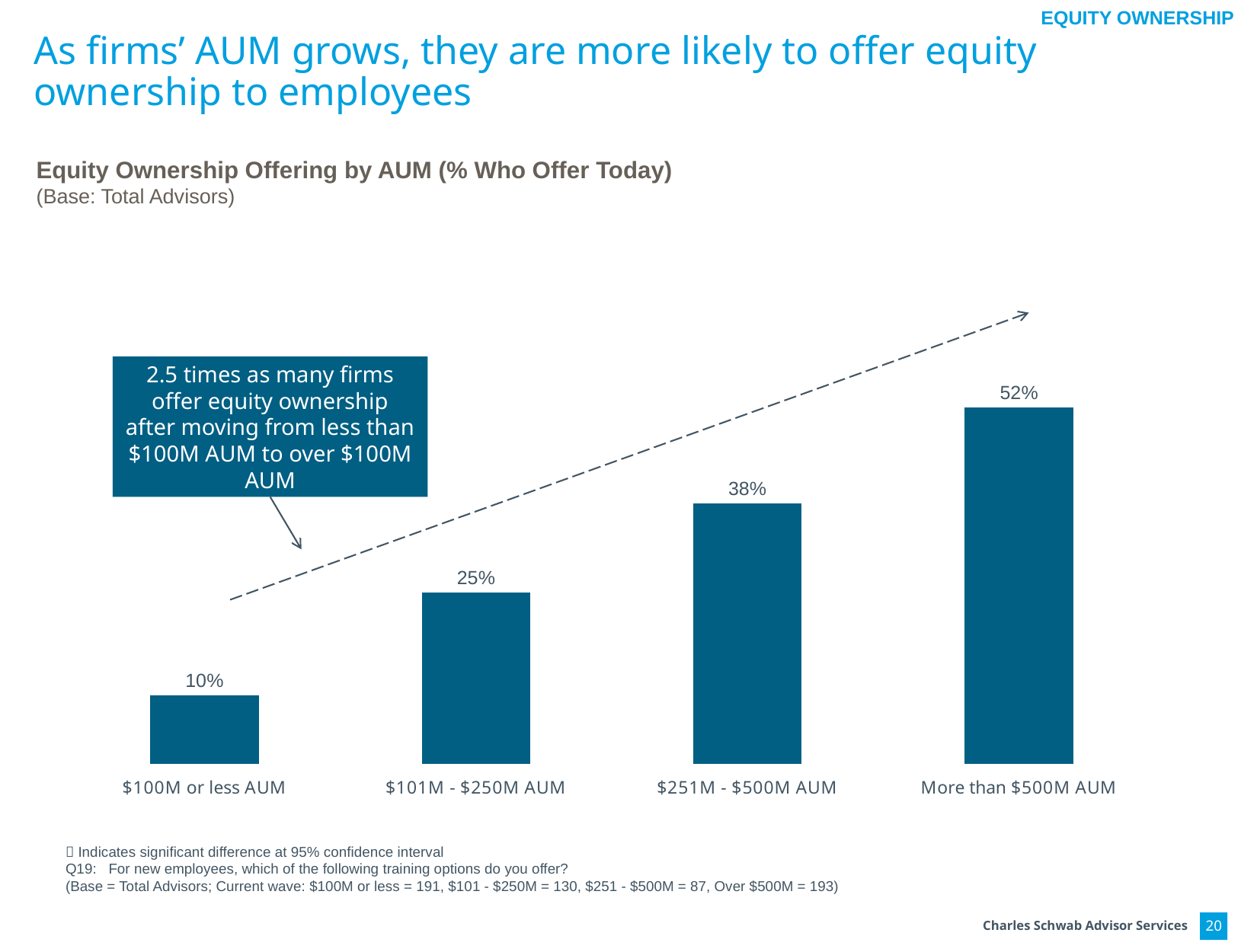
Which AUM category has the highest percentage of firms offering equity ownership? More than $500M AUM What percentage is shown for firms with $251M - $500M AUM? 38% Do the values rise or fall as AUM increases from left to right along the x axis? Rise Which is larger: the value for $101M - $250M AUM or the value for $251M - $500M AUM? $251M - $500M AUM What type of chart is used on this slide? Bar chart How many AUM categories are shown in the chart? 4 Which AUM category has the lowest percentage of firms offering equity ownership? $100M or less AUM What is the difference between the $251M - $500M AUM value and the $101M - $250M AUM value? 13 percentage points What is the value shown for the $101M - $250M AUM category? 25% What percentage of firms with $100M or less AUM offer equity ownership today? 10% What is the difference in percentage points between the More than $500M AUM category and the $100M or less AUM category? 42 percentage points What is the value for the More than $500M AUM category? 52%